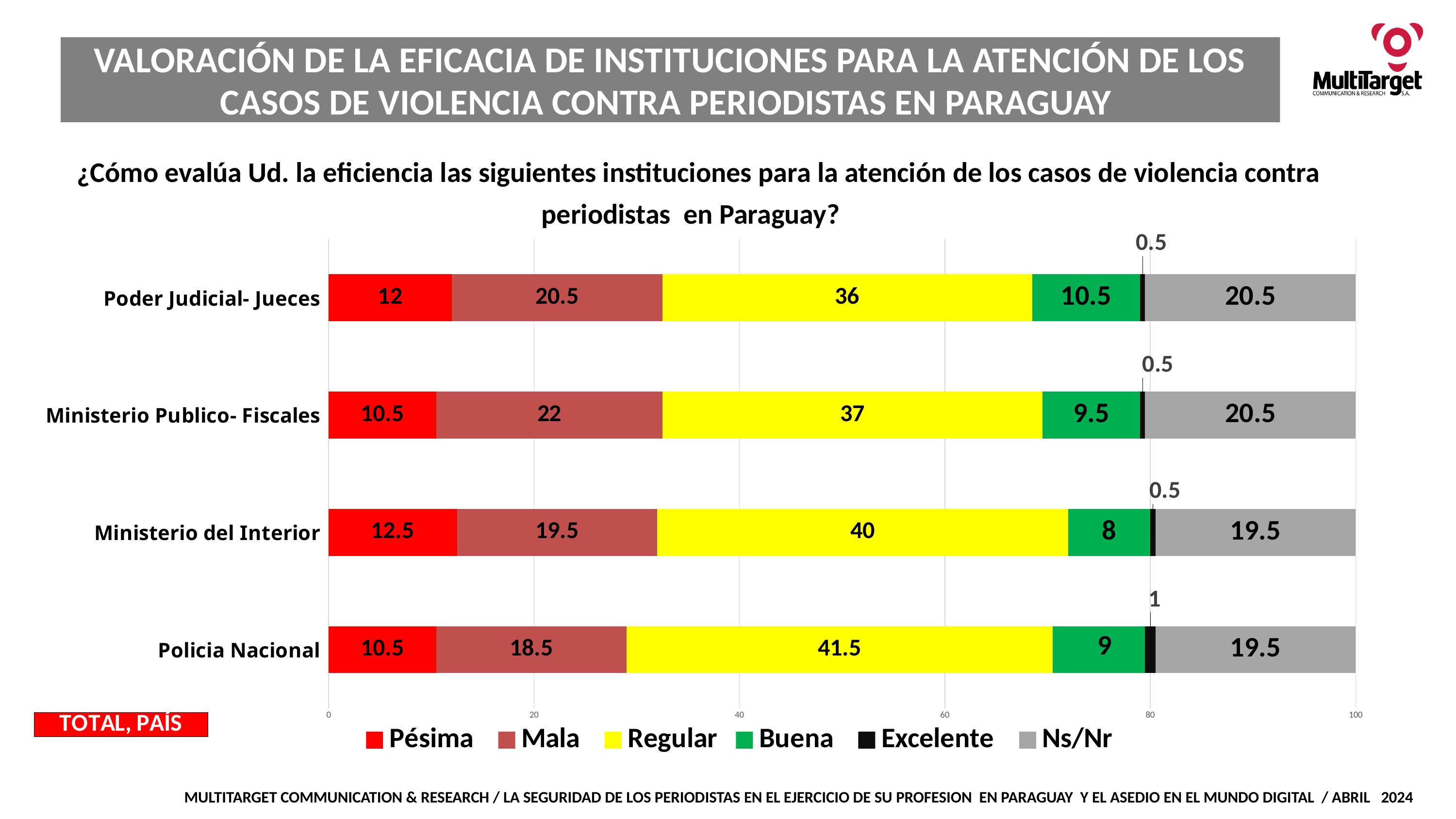
What is the difference between the Mala value for Ministerio Publico- Fiscales and the Mala value for Policia Nacional? 3.5 Which institution has the lowest value for Buena? Ministerio del Interior How many series does the legend list? 6 What is the value for Pésima for Ministerio del Interior? 12.5 Which institution has the highest value for Regular? Policia Nacional How many institutions are shown on the chart? 4 What kind of chart is shown on the slide? Stacked bar chart Which has the larger Pésima value, Poder Judicial- Jueces or Ministerio del Interior? Ministerio del Interior What is the value for Buena for Poder Judicial- Jueces? 10.5 What is the value for Regular for Policia Nacional? 41.5 What is the total of the stacked bar for Poder Judicial- Jueces? 100 What is the value for Excelente for Policia Nacional? 1